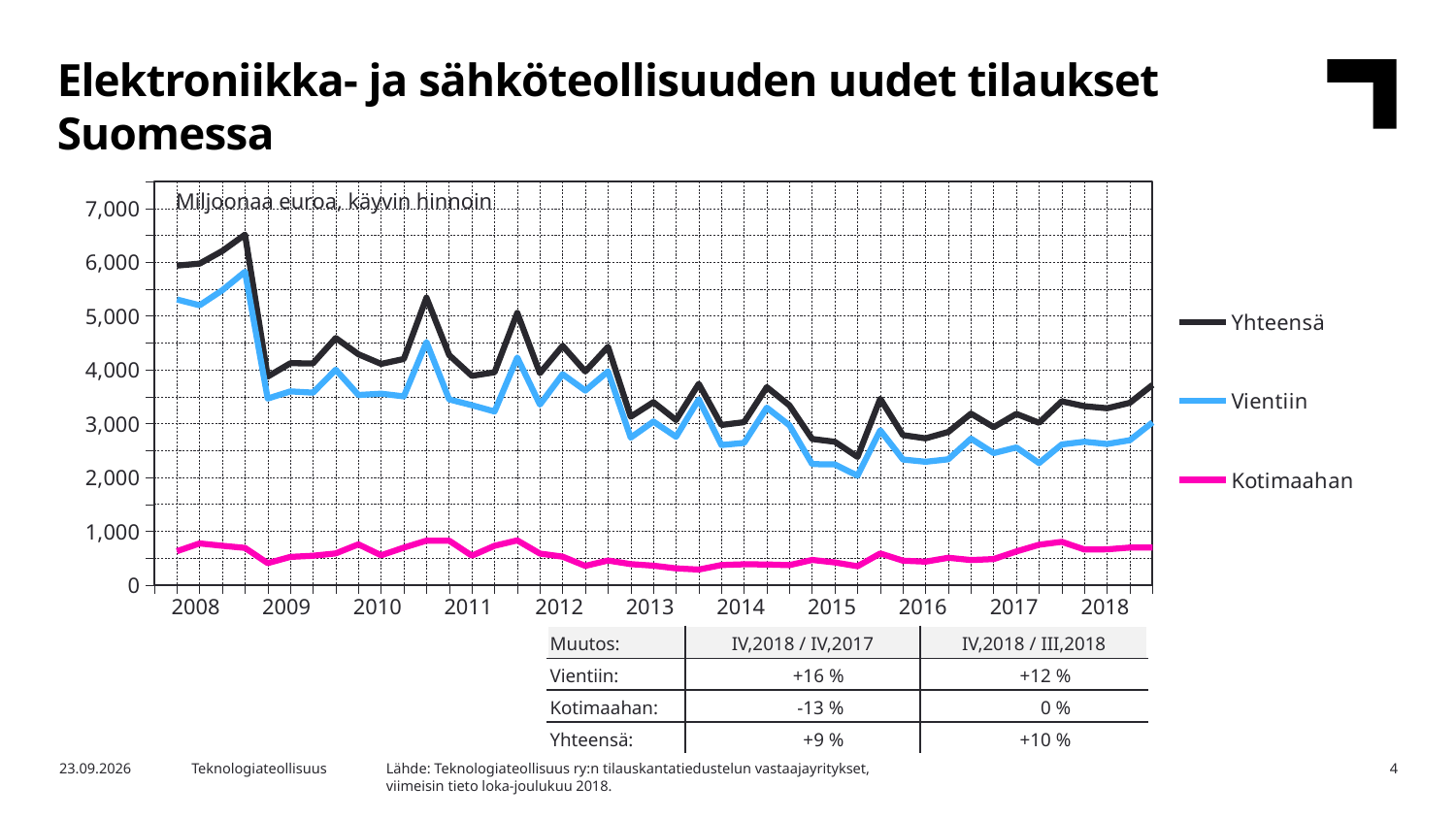
How many years are labelled on the x axis? 11 Which series has the lowest values throughout the chart? Kotimaahan Which series has the highest values throughout the chart? Yhteensä Is the value for Kotimaahan in 2018 greater or less than 1,000? less Is the value for Yhteensä at the start of 2008 greater or less than 5,000? greater What type of chart is shown on the slide? line chart What unit is stated in the chart's subtitle? Miljoonaa euroa, käyvin hinnoin In the table below the chart, what is the change for Vientiin for IV,2018 / IV,2017? +16 % How many series does the legend list? 3 Overall, do the Yhteensä values rise or fall from 2008 to 2018? fall Which series is shown in pink in the chart? Kotimaahan Is the value for Vientiin in 2016 greater or less than 3,000? less